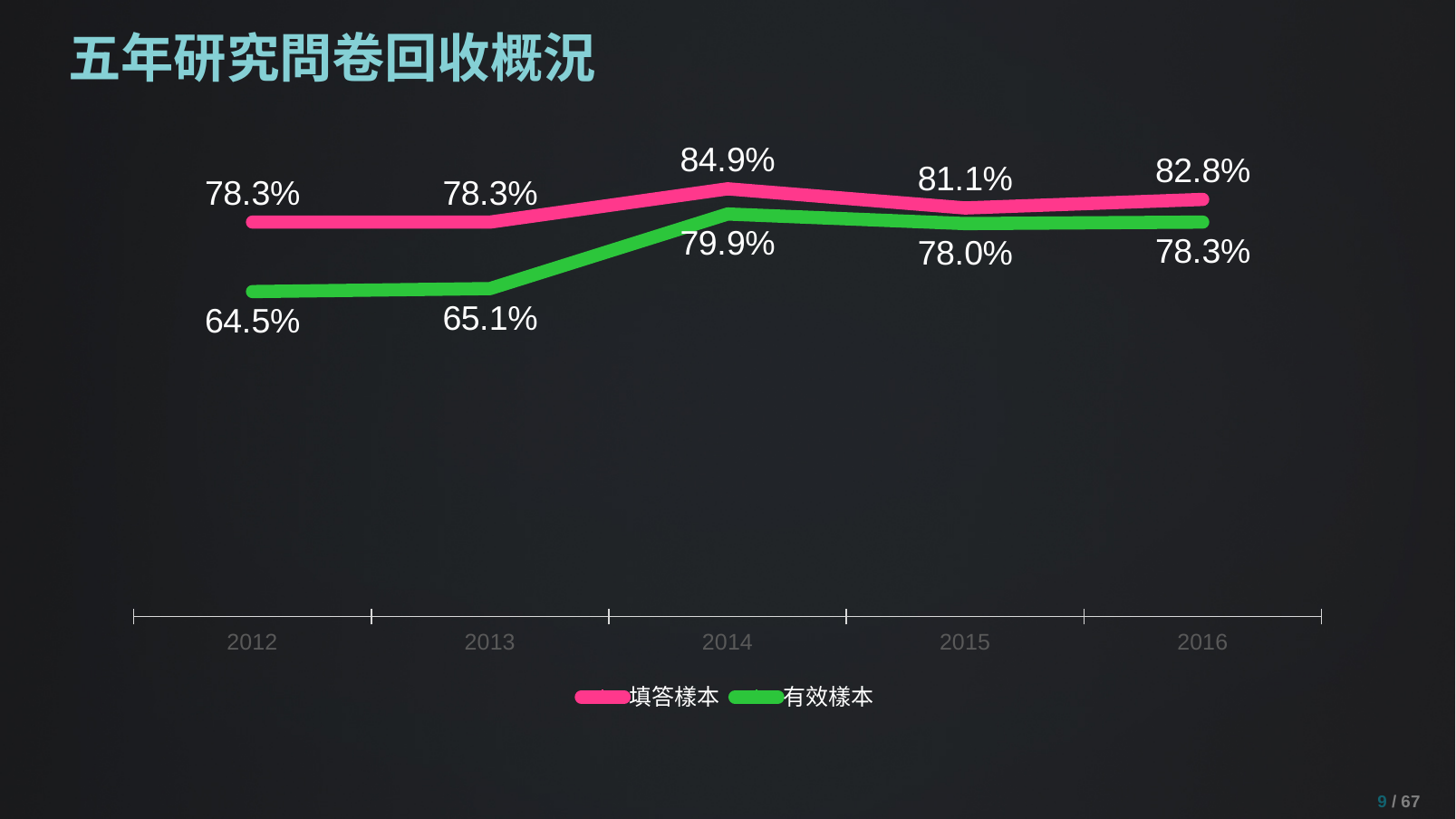
What is the difference between 填答樣本 in 2014 and 填答樣本 in 2013? 6.6% What is the value for 填答樣本 in 2016? 82.8% How many series does the legend list? 2 In which year is 填答樣本 highest? 2014 What is the value for 填答樣本 in 2014? 84.9% What kind of chart is shown on the slide? Line chart What is the value for 有效樣本 in 2012? 64.5% How many years are shown on the x axis? 5 What is the difference between 填答樣本 and 有效樣本 in 2012? 13.8% Which is larger in 2016, 填答樣本 or 有效樣本? 填答樣本 In which year is 有效樣本 lowest? 2012 What is the value for 有效樣本 in 2015? 78.0%